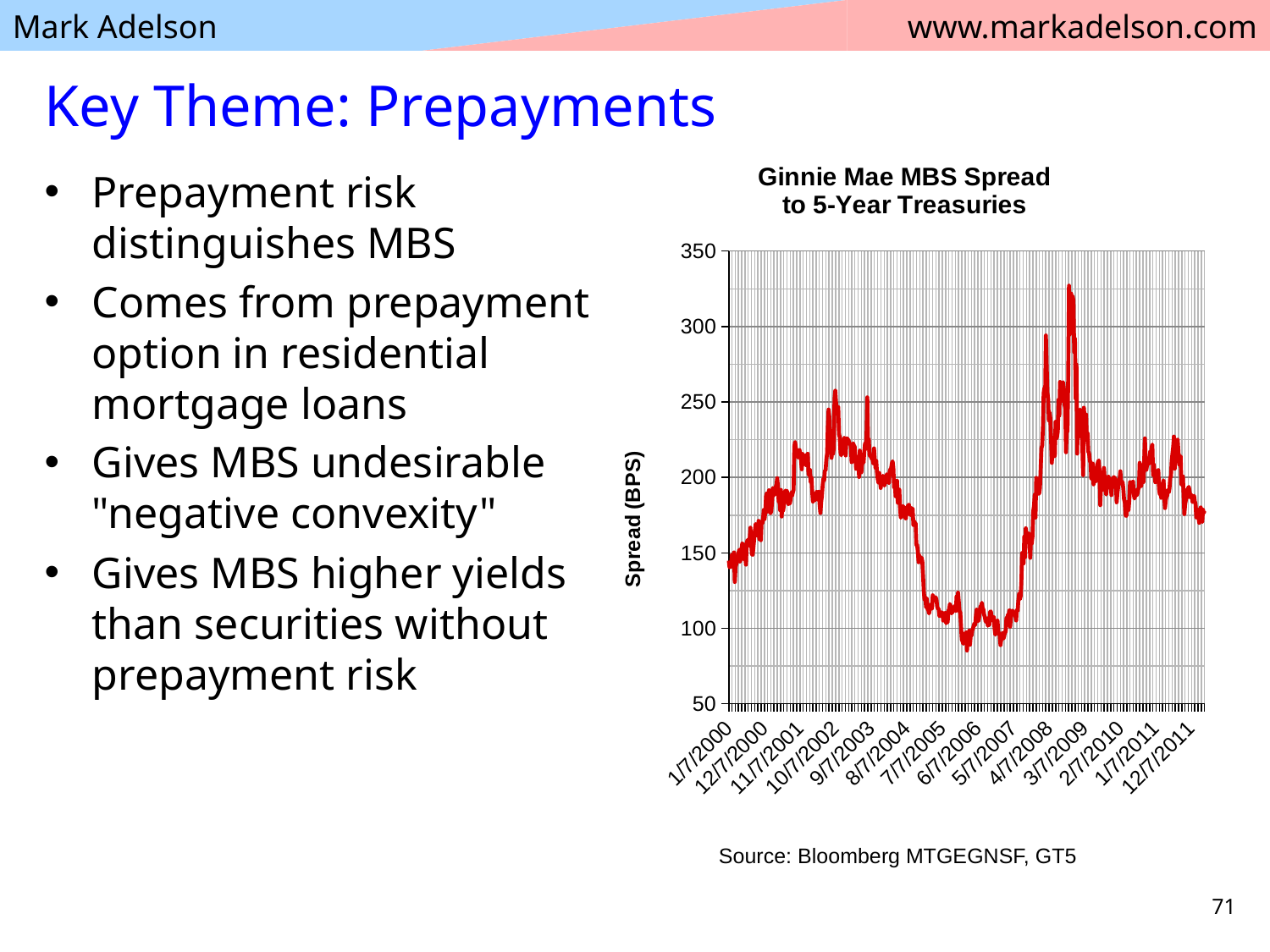
Is the spread at the highest peak of the chart greater or less than 300? greater Is the spread around 6/7/2006 greater or less than 150? less What kind of chart is shown on the slide? line chart Is the spread at 1/7/2000 greater or less than 200? less What is the highest value shown on the vertical axis? 350 How many date labels are shown on the horizontal axis? 14 What is the label on the vertical axis of the chart? Spread (BPS) Between 8/7/2004 and 7/7/2005, does the spread rise or fall? fall What is the title of the chart? Ginnie Mae MBS Spread to 5-Year Treasuries Between 5/7/2007 and 4/7/2008, does the spread rise or fall? rise